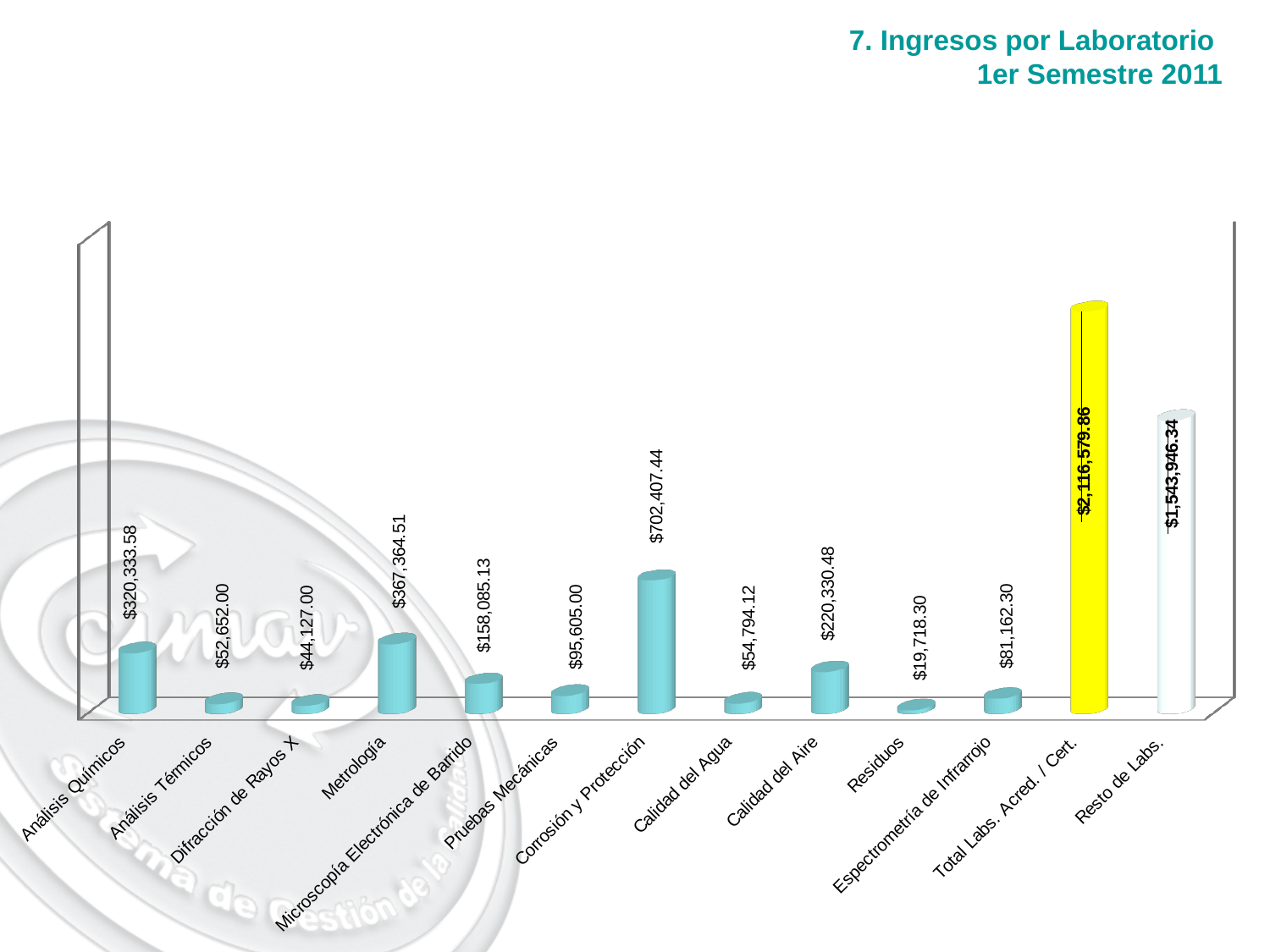
Which category has the highest value in the chart? Total Labs. Acred. / Cert. What is the value shown for Total Labs. Acred. / Cert.? $2,116,579.86 What kind of chart is shown on the slide? Bar chart What is the value shown for Metrología? $367,364.51 Which category has the lowest value in the chart? Residuos What is the value shown for Residuos? $19,718.30 What is the value shown for Corrosión y Protección? $702,407.44 How many categories are shown on the x axis of the chart? 13 What is the difference between the values for Total Labs. Acred. / Cert. and Resto de Labs.? $572,633.52 What is the title of the chart on the slide? 7. Ingresos por Laboratorio 1er Semestre 2011 Which is larger, the value for Análisis Químicos or the value for Metrología? Metrología What is the difference between the values for Corrosión y Protección and Calidad del Aire? $482,076.96